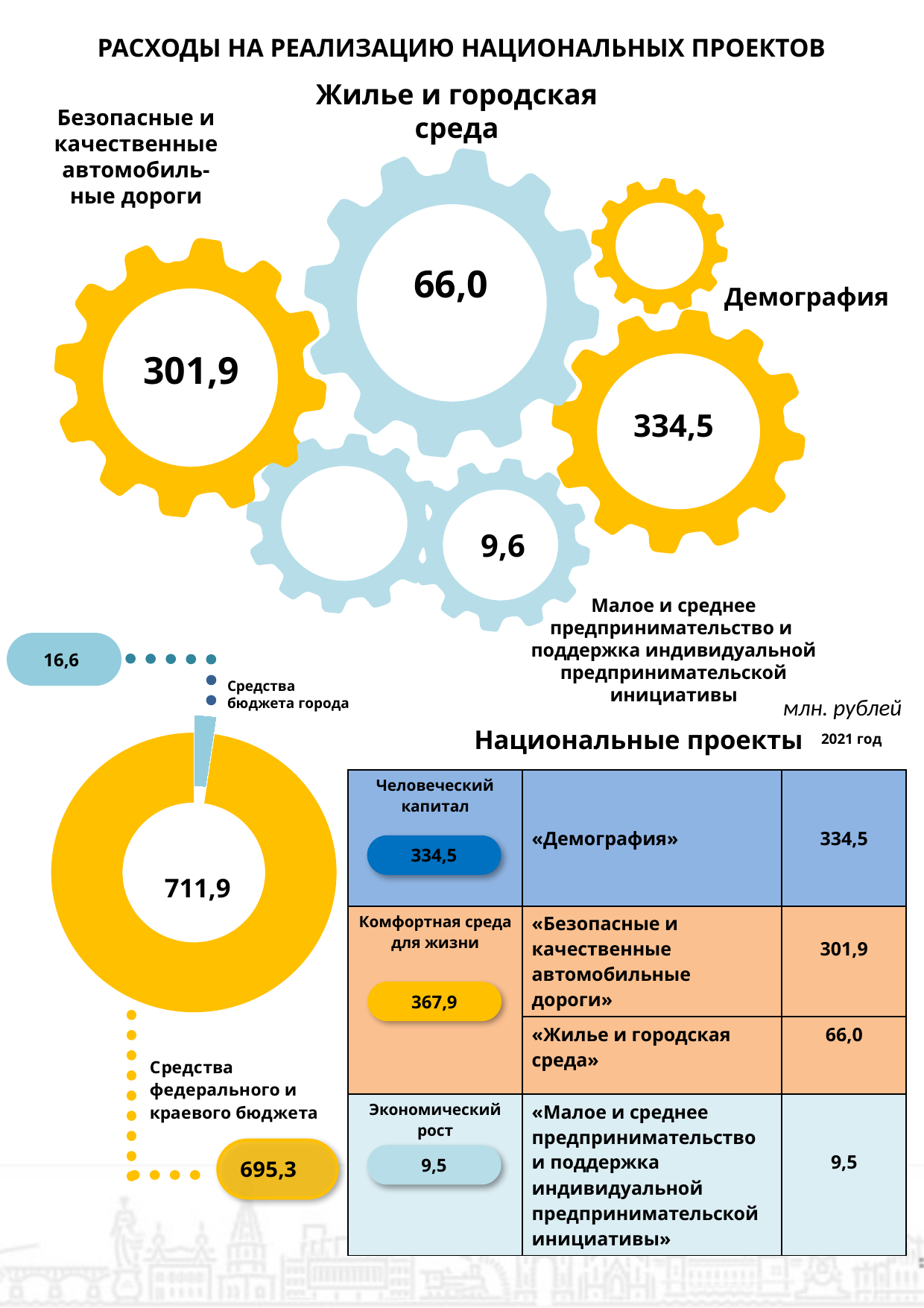
In the pie chart at the bottom left, what is the difference between «Средства федерального и краевого бюджета» and «Средства бюджета города»? 678,7 How many slices does the pie chart at the bottom left have? 2 In the gear diagram at the top of the slide, what value is shown for «Жилье и городская среда»? 66,0 In the gear diagram at the top of the slide, what value is shown for «Демография»? 334,5 What kind of chart is shown at the bottom left of the slide? doughnut chart In the pie chart at the bottom left, what colour is the «Средства бюджета города» slice? light blue What total is printed in the centre of the pie chart at the bottom left? 711,9 In the pie chart at the bottom left, which is larger: «Средства бюджета города» or «Средства федерального и краевого бюджета»? Средства федерального и краевого бюджета In the pie chart at the bottom left, what is the value for «Средства бюджета города»? 16,6 In the pie chart at the bottom left, which slice is the largest? Средства федерального и краевого бюджета In the pie chart at the bottom left, which slice is the smallest? Средства бюджета города In the pie chart at the bottom left, what is the value for «Средства федерального и краевого бюджета»? 695,3